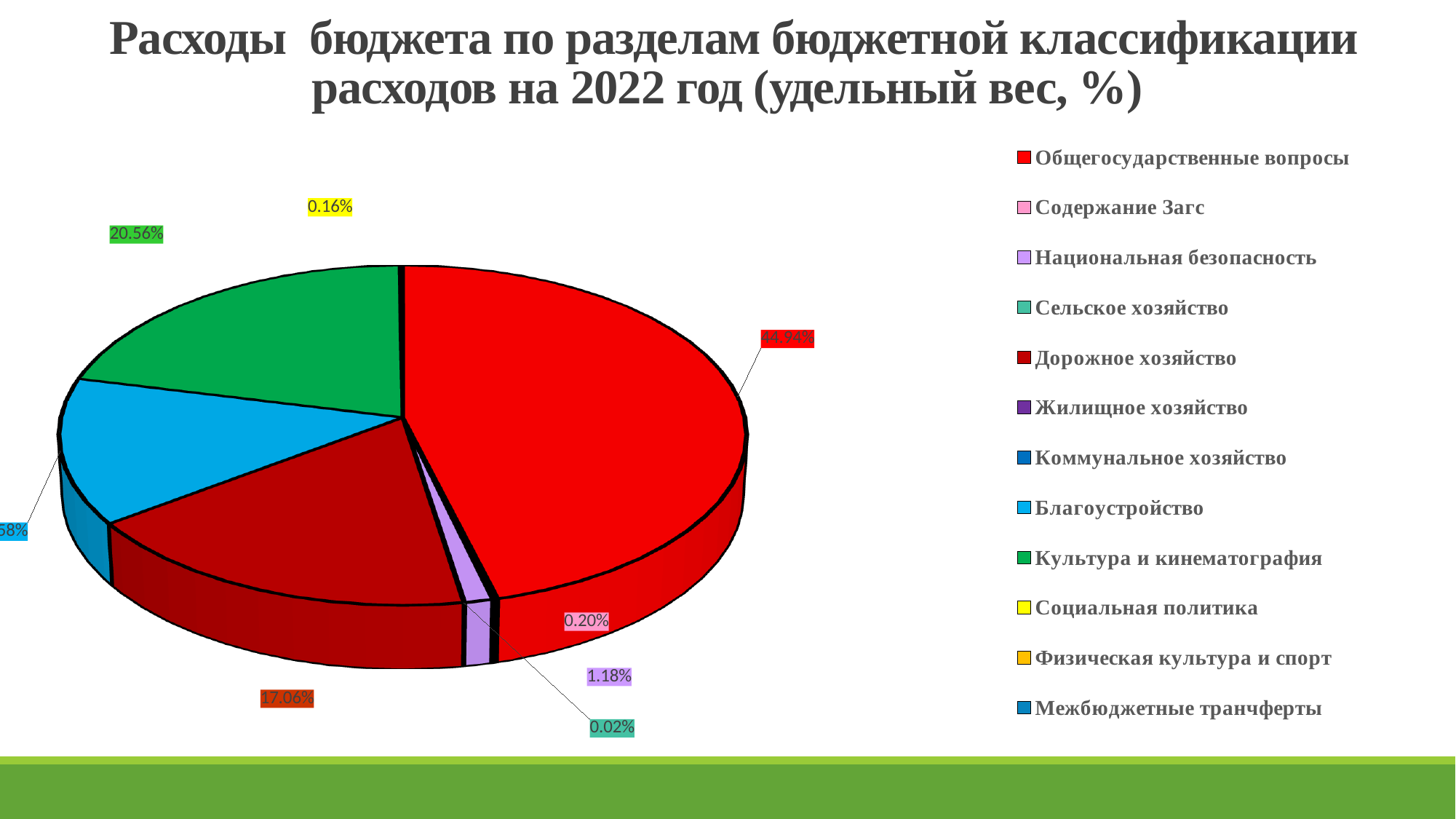
What share does Общегосударственные вопросы have in the pie chart? 44.94% What is the difference between the shares of Общегосударственные вопросы and Культура и кинематография? 24.38% Which has the larger share: Культура и кинематография or Дорожное хозяйство? Культура и кинематография What share does Национальная безопасность have in the pie chart? 1.18% Which category has the largest slice of the pie chart? Общегосударственные вопросы How many entries does the legend of the pie chart list? 12 What share does Социальная политика have in the pie chart? 0.16% What share does Содержание Загс have in the pie chart? 0.20% What kind of chart is shown on the slide? pie chart What share does Сельское хозяйство have in the pie chart? 0.02% What share does Дорожное хозяйство have in the pie chart? 17.06% What share does Культура и кинематография have in the pie chart? 20.56%